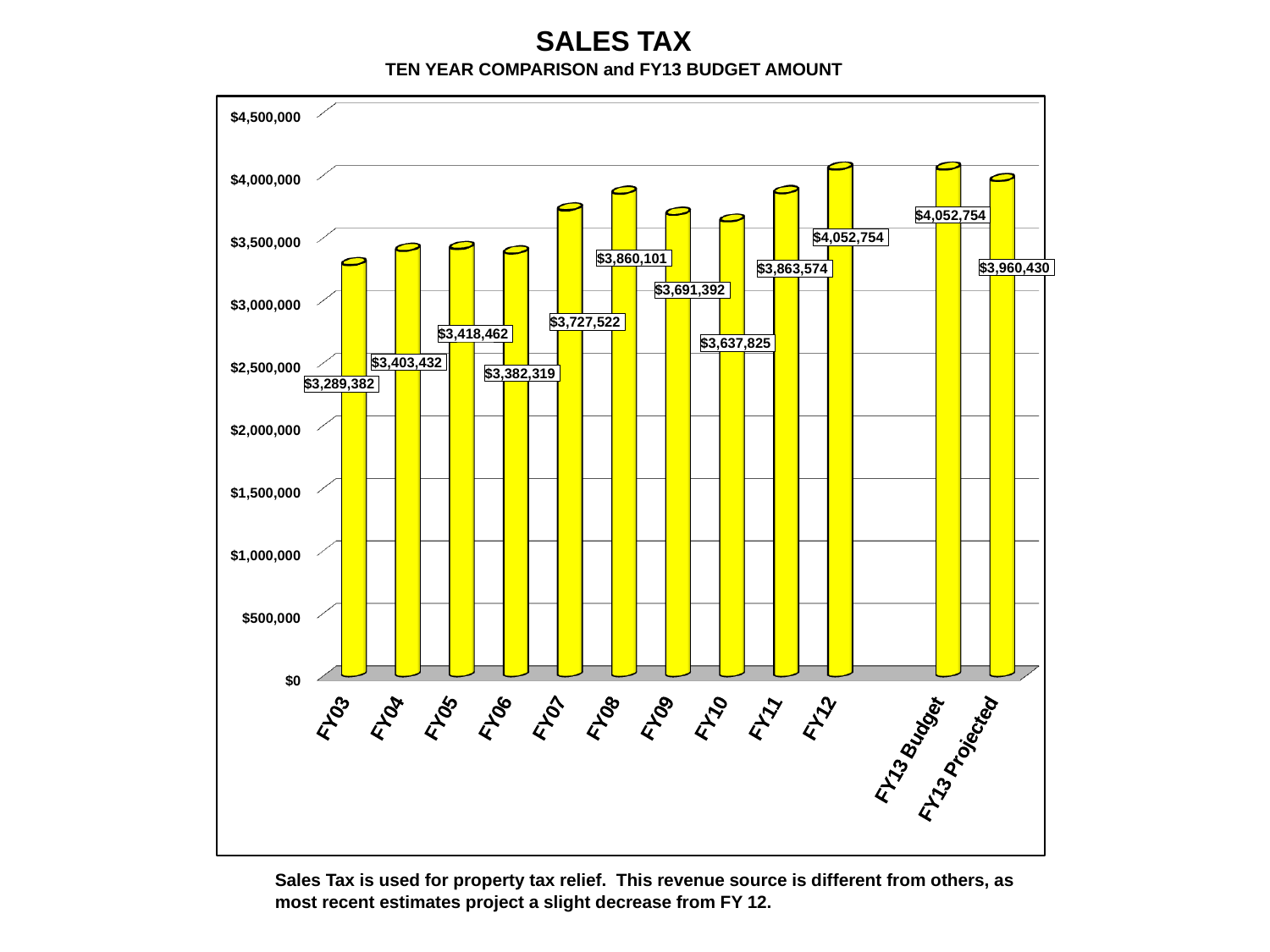
How many bars are shown in the chart? 12 Do the values rise or fall from FY08 to FY10? fall Which fiscal year has the lowest sales tax value? FY03 What is the difference between the FY08 value and the FY07 value? $132,579 What is the sales tax value for FY10? $3,637,825 What is the sales tax value for FY13 Projected? $3,960,430 What is the subtitle of the chart? TEN YEAR COMPARISON and FY13 BUDGET AMOUNT What kind of chart is shown on the slide? bar chart What is the sales tax value for FY07? $3,727,522 Which is larger, the value for FY05 or the value for FY10? FY10 What is the difference between the FY12 value and the FY13 Projected value? $92,324 Is the value for FY12 greater or less than $4,000,000? greater